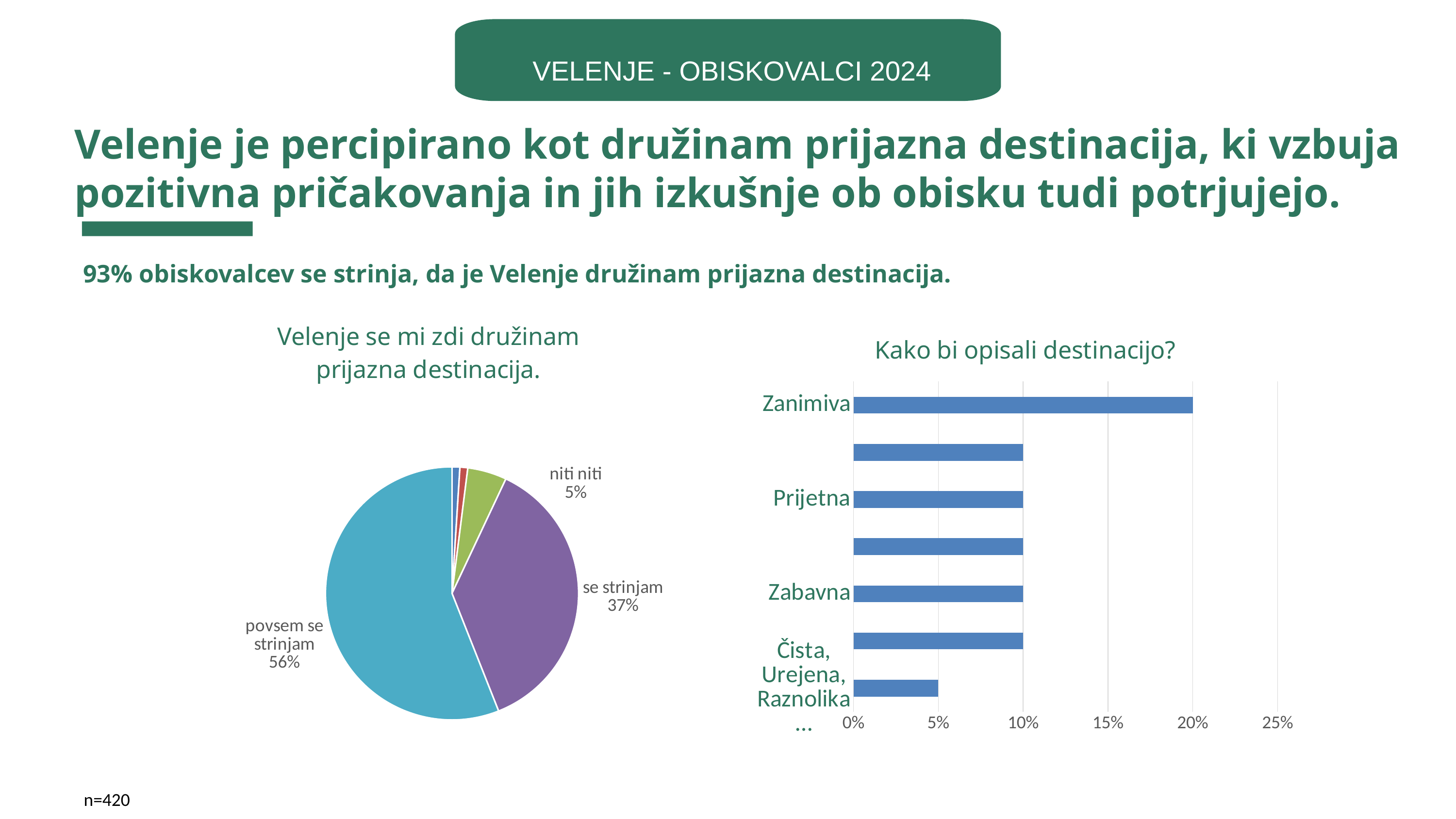
In the pie chart 'Velenje se mi zdi družinam prijazna destinacija.', what share is labelled 'se strinjam'? 37% In the bar chart 'Kako bi opisali destinacijo?', which labelled category has the highest value? Zanimiva What kind of chart is 'Kako bi opisali destinacijo?'? bar chart How many bars are plotted in the bar chart 'Kako bi opisali destinacijo?'? 7 In the pie chart 'Velenje se mi zdi družinam prijazna destinacija.', which is larger: 'se strinjam' or 'niti niti'? se strinjam In the bar chart 'Kako bi opisali destinacijo?', is the value for 'Zabavna' greater or less than 15%? less In the pie chart 'Velenje se mi zdi družinam prijazna destinacija.', what share is labelled 'niti niti'? 5% In the pie chart 'Velenje se mi zdi družinam prijazna destinacija.', how many percentage points larger is 'povsem se strinjam' than 'se strinjam'? 19% In the bar chart 'Kako bi opisali destinacijo?', what is the value for 'Prijetna'? 10% In the bar chart 'Kako bi opisali destinacijo?', what is the value for 'Zanimiva'? 20% In the pie chart 'Velenje se mi zdi družinam prijazna destinacija.', which labelled slice is the largest? povsem se strinjam In the pie chart 'Velenje se mi zdi družinam prijazna destinacija.', what share is labelled 'povsem se strinjam'? 56%